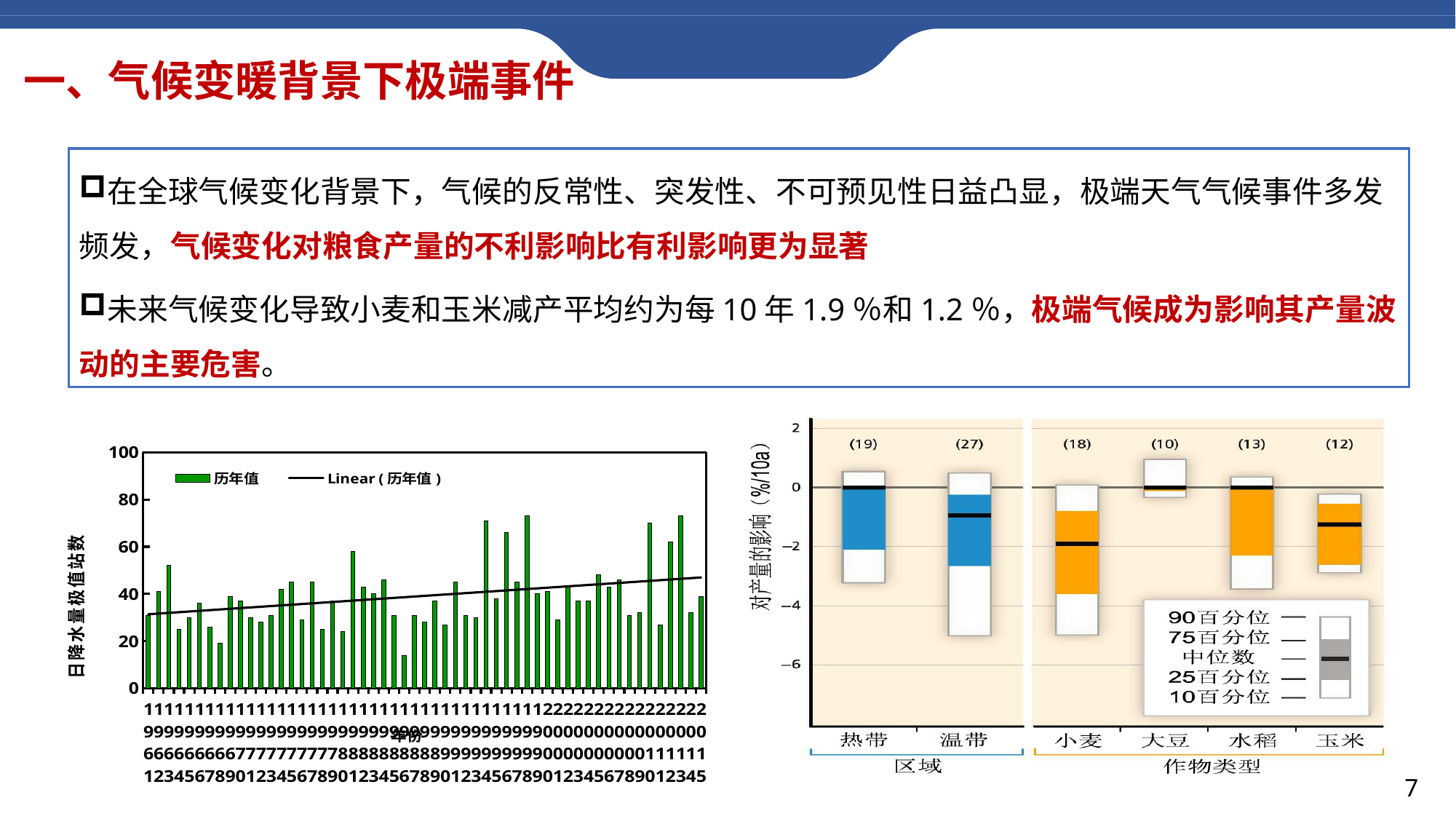
In the left chart, what is the highest value shown on the y axis? 100 In the left chart, how many series does the legend list? 2 In the left chart, does the linear trend line rise or fall from left to right along the x axis? rise In the right chart, which crop type has the lowest median impact on yield? 小麦 In the right chart, how many categories are shown along the x axis? 6 In the right chart, which has the lower median impact on yield, 小麦 or 玉米? 小麦 In the left chart, is the value for the year 1961 greater or less than 60? less In the right chart, what sample count is printed above the 温带 box? (27) In the right chart, is the median value for 小麦 greater or less than -1? less In the left chart, what are the two legend entries? 历年值, Linear (历年值) In the right chart, what sample count is printed above the 大豆 box? (10) What kind of chart is the chart on the left of the slide? bar chart